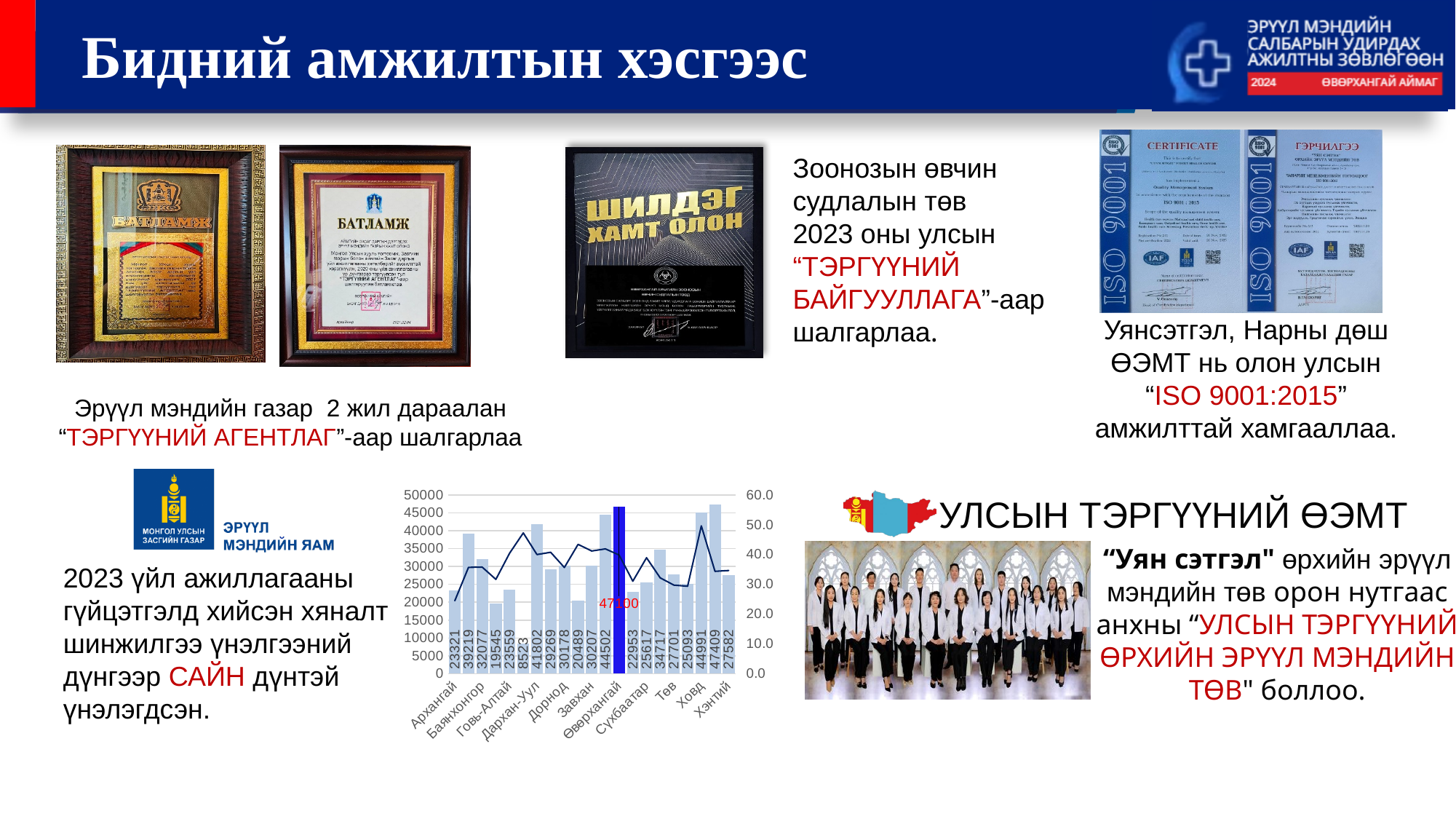
What is the value of the bar for Төв in the chart? 27701 What is the difference between the bar values for Өвөрхангай and Архангай? 23779 What kind of chart is shown on the slide? Bar chart with a line overlay What is the value of the bar for Дархан-Уул in the chart? 41802 Is the bar value for Баянхонгор greater or less than 30000? greater Which has the larger bar value, Дархан-Уул or Хэнтий? Дархан-Уул Which category's bar is highlighted in a different colour (blue) in the chart? Өвөрхангай What is the value of the bar for Ховд in the chart? 44991 How many bars are plotted in the chart? 21 What is the value of the bar for Өвөрхангай in the chart? 47100 What is the lowest bar value printed in the chart? 8523 What is the value of the bar for Архангай in the chart? 23321